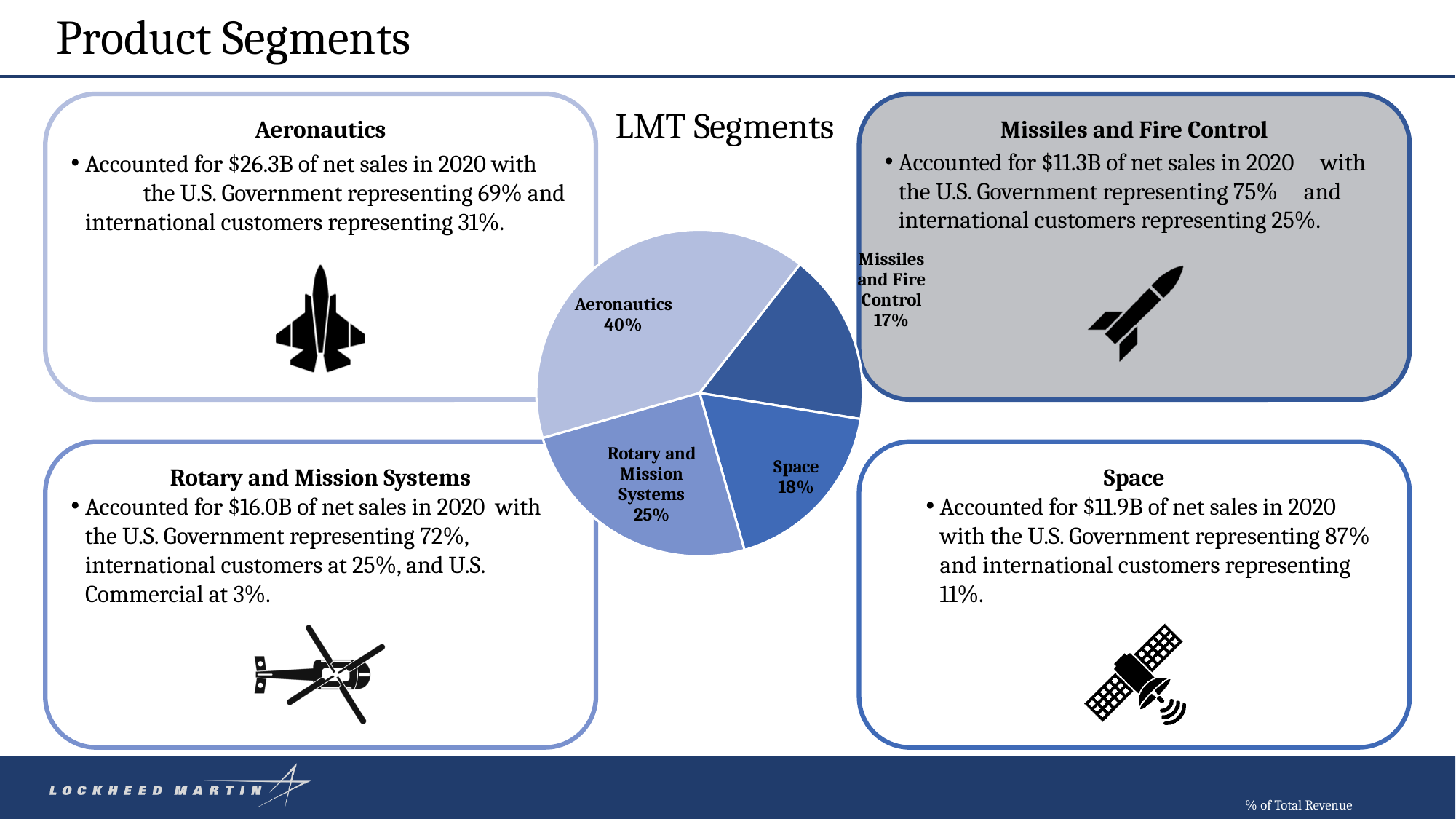
Which segment has the largest share of the pie? Aeronautics What share of the pie does Missiles and Fire Control represent? 17% What type of chart is shown on the slide? pie chart What share of the pie does Aeronautics represent? 40% Which is larger, the share for Space or the share for Rotary and Mission Systems? Rotary and Mission Systems How many segments are shown in the pie chart? 4 What is the title of the chart? LMT Segments Which segment has the smallest share of the pie? Missiles and Fire Control What share of the pie does Space represent? 18% What share of the pie does Rotary and Mission Systems represent? 25% What is the difference in percentage points between Aeronautics and Rotary and Mission Systems? 15 What is the combined share of Space and Missiles and Fire Control? 35%